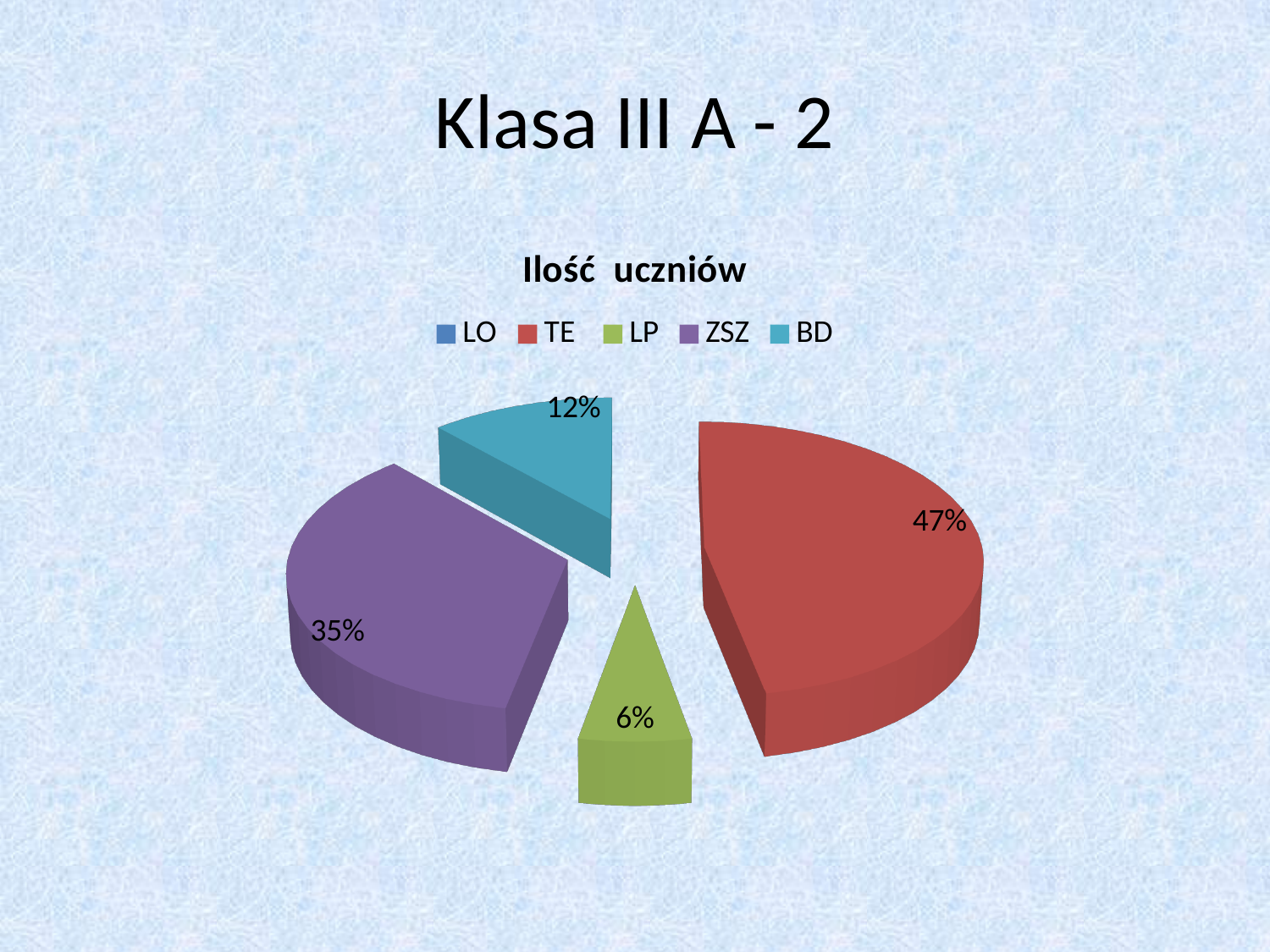
Which category with a visible slice has the smallest share of the pie? LP Which category has the largest slice of the pie? TE What share of the pie does BD have? 12% What share of the pie does LP have? 6% What share of the pie does TE have? 47% What colour is the TE slice? red What is the title of the chart? Ilość uczniów How many entries does the chart legend list? 5 Which slice is larger, BD or LP? BD What kind of chart is shown on the slide? pie chart What is the difference in percentage points between the TE and ZSZ slices? 12